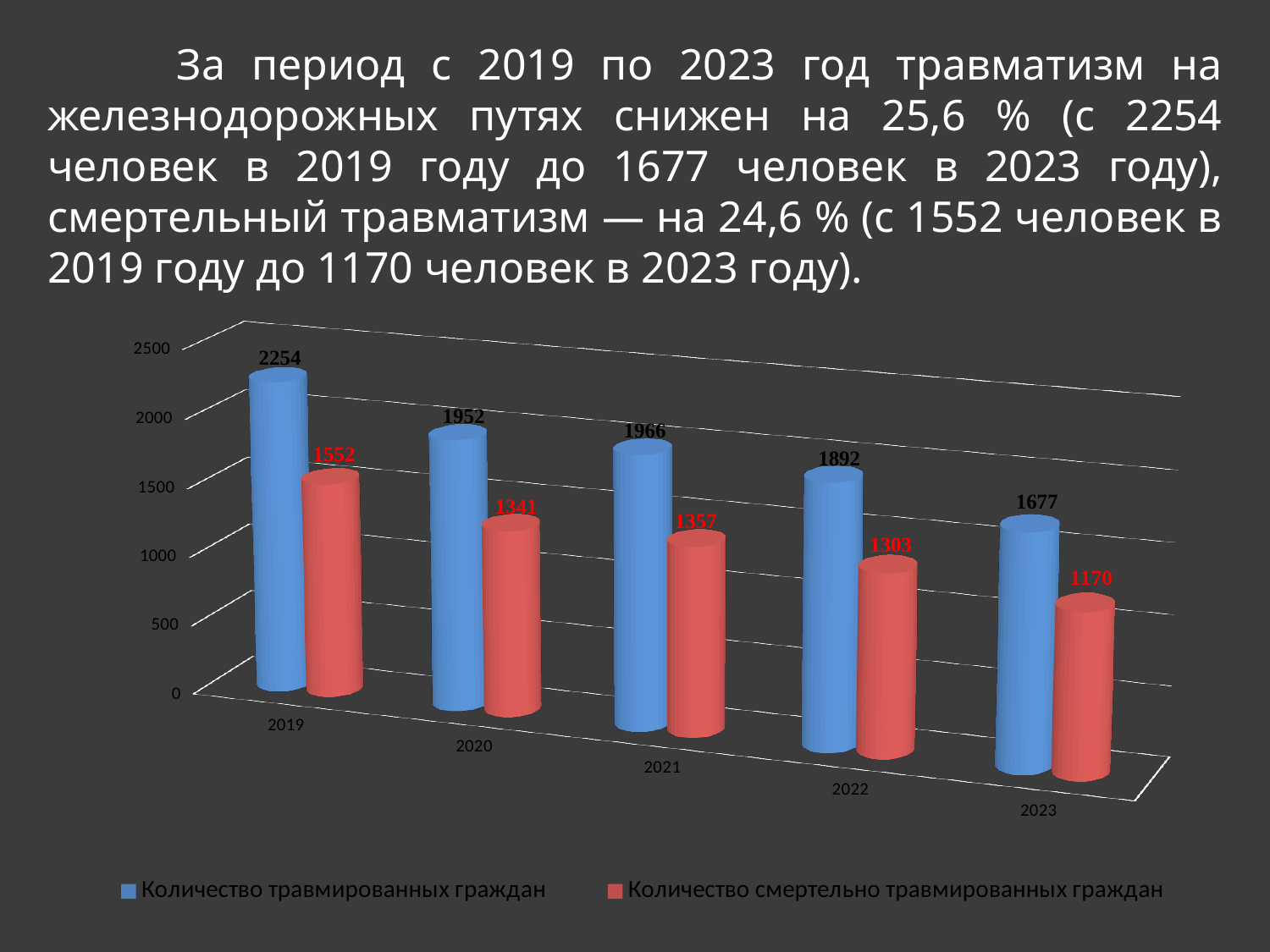
Is the value for "Количество травмированных граждан" in 2023 greater or less than 1500? greater How many series does the legend list? 2 In which year is "Количество травмированных граждан" highest? 2019 In which year is "Количество смертельно травмированных граждан" lowest? 2023 What is the value for "Количество смертельно травмированных граждан" in 2021? 1357 What is the value for "Количество смертельно травмированных граждан" in 2023? 1170 What is the difference between "Количество травмированных граждан" and "Количество смертельно травмированных граждан" in 2022? 589 Which is larger: "Количество травмированных граждан" in 2020 or in 2021? 2021 How many years are shown on the x axis? 5 What is the value for "Количество травмированных граждан" in 2019? 2254 Which colour represents "Количество смертельно травмированных граждан" in the chart? red What kind of chart is shown on the slide? bar chart